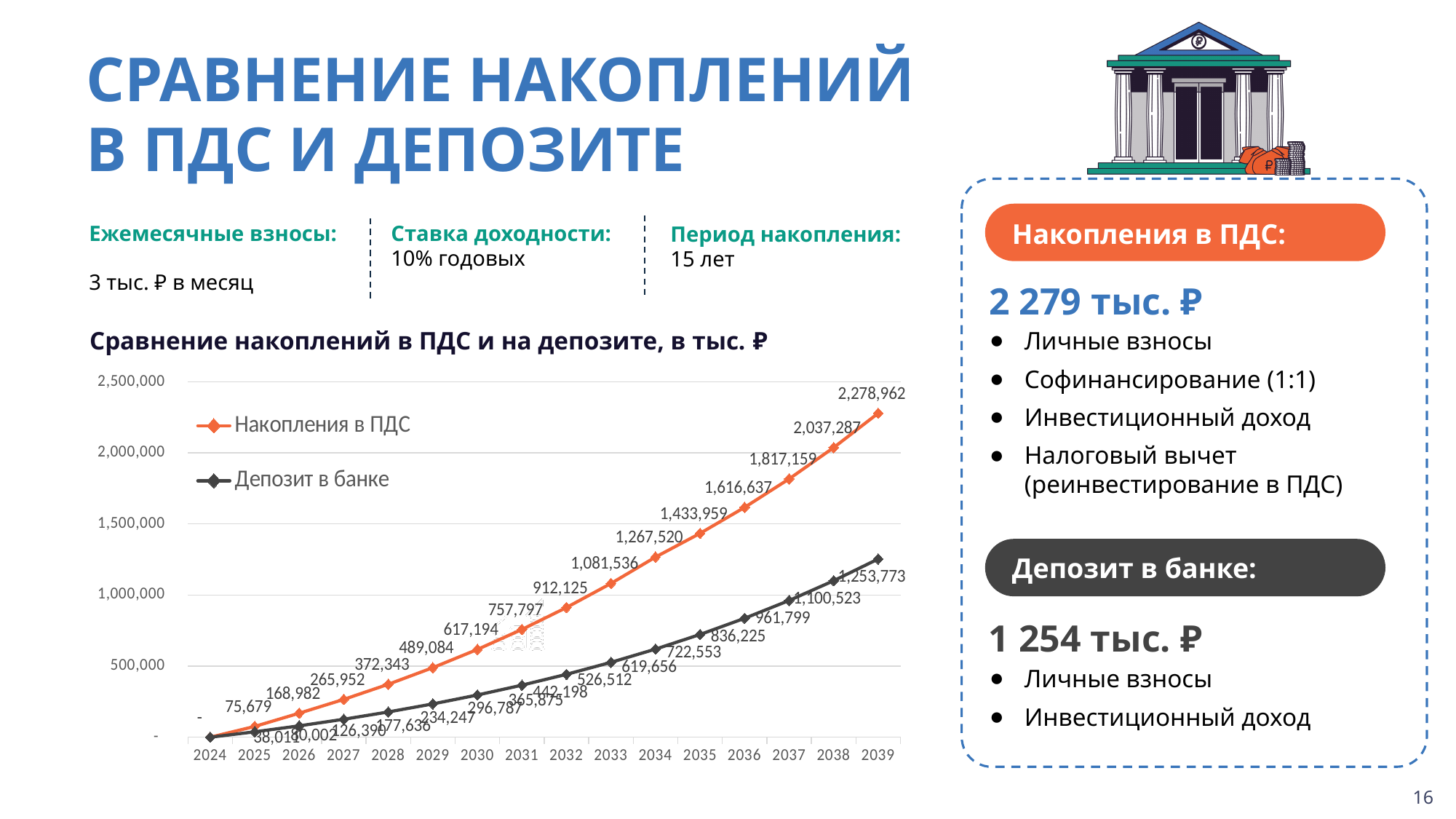
What is the value of Накопления в ПДС in 2030? 617,194 What is the difference between Накопления в ПДС and Депозит в банке in 2039? 1,025,189 Which series has the higher value in 2036: Накопления в ПДС or Депозит в банке? Накопления в ПДС What is the value of Накопления в ПДС in 2039? 2,278,962 What type of chart is shown on the slide? Line chart How many years are shown on the x axis of the chart? 16 What is the value of Депозит в банке in 2039? 1,253,773 What is the value of Депозит в банке in 2035? 722,553 Do the values of Депозит в банке rise or fall from 2024 to 2039? Rise How many series does the chart legend list? 2 What is the difference between Накопления в ПДС and Депозит в банке in 2030? 320,407 In which year does Накопления в ПДС reach its highest value? 2039